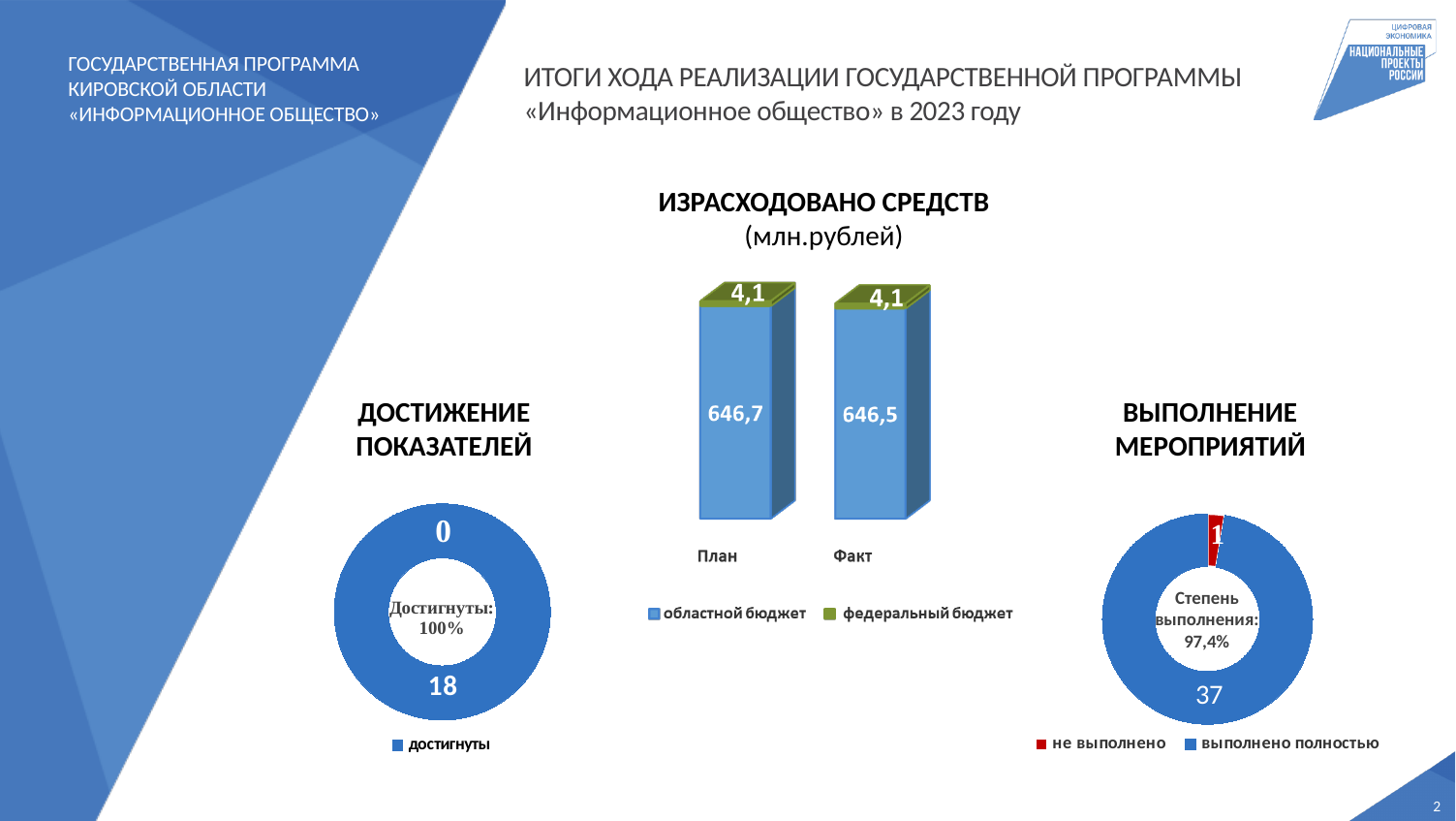
How many series does the legend of the "ИЗРАСХОДОВАНО СРЕДСТВ" chart list? 2 In the "ВЫПОЛНЕНИЕ МЕРОПРИЯТИЙ" chart on the right, what is the value for выполнено полностью? 37 In the "ИЗРАСХОДОВАНО СРЕДСТВ" chart, what is the total of the План bar? 650,8 In the "ДОСТИЖЕНИЕ ПОКАЗАТЕЛЕЙ" chart on the left, what is the value for достигнуты? 18 What type of chart is the "ИЗРАСХОДОВАНО СРЕДСТВ" chart in the centre of the slide? Bar chart In the "ИЗРАСХОДОВАНО СРЕДСТВ" chart, what is the difference between областной бюджет for План and for Факт? 0,2 In the "ИЗРАСХОДОВАНО СРЕДСТВ" chart, what is the value of областной бюджет for План? 646,7 In the "ВЫПОЛНЕНИЕ МЕРОПРИЯТИЙ" chart on the right, what is the value for не выполнено? 1 In the "ИЗРАСХОДОВАНО СРЕДСТВ" chart, what is the value of федеральный бюджет for План? 4,1 In the "ИЗРАСХОДОВАНО СРЕДСТВ" chart, what is the value of областной бюджет for Факт? 646,5 How many categories are shown on the x axis of the "ИЗРАСХОДОВАНО СРЕДСТВ" chart? 2 What percentage is shown in the centre of the "ВЫПОЛНЕНИЕ МЕРОПРИЯТИЙ" chart on the right? 97,4%